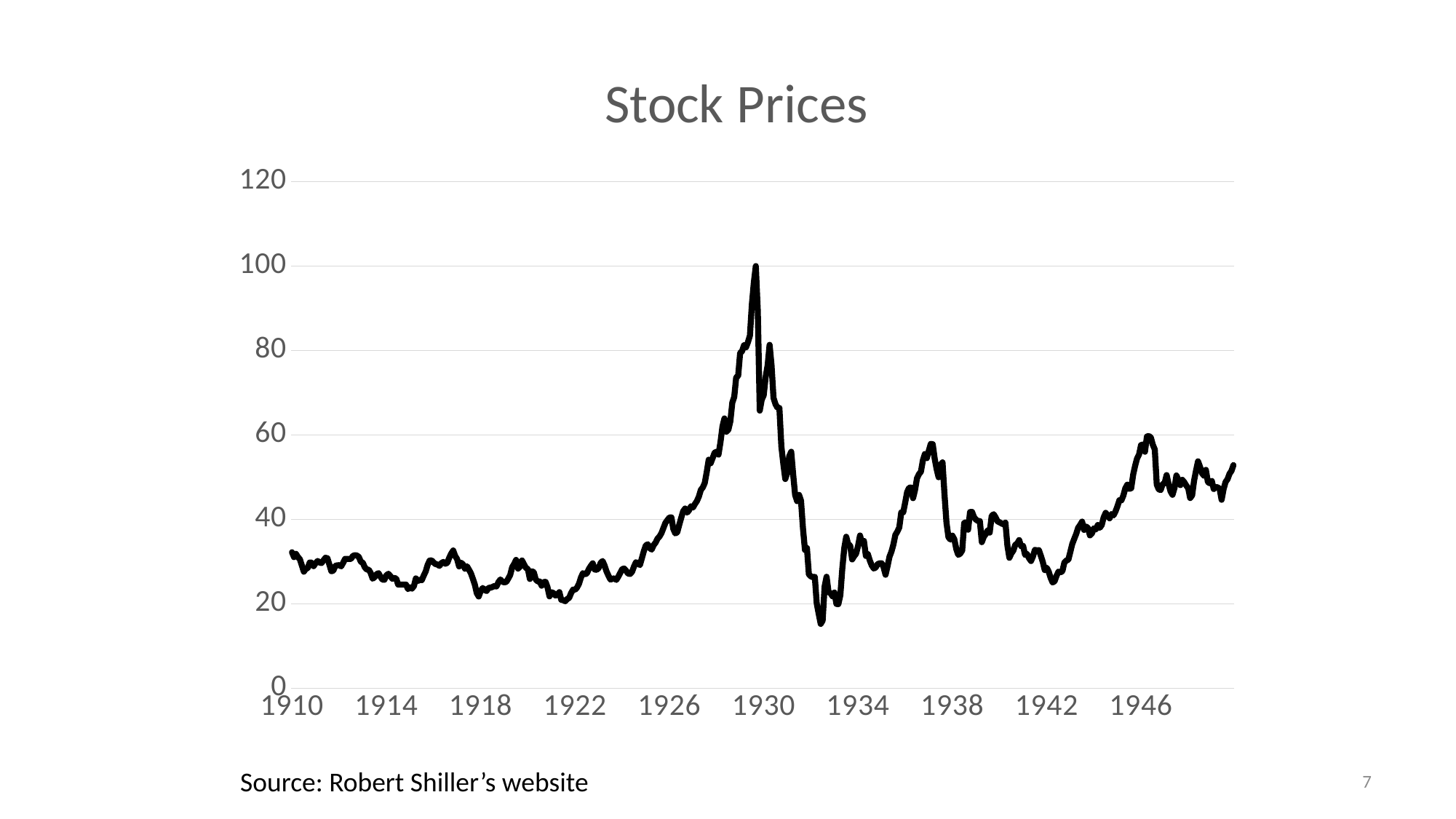
What is the title of the chart? Stock Prices What source is cited for the chart's data? Robert Shiller's website How many lines (series) are plotted on the chart? 1 Around which year does the stock price line reach its highest point? 1929 Is the value at the 1929 peak greater or less than 80? greater Do stock prices rise or fall between 1922 and 1929? rise Is the lowest value reached around 1932 greater or less than 20? less Do stock prices rise or fall between 1929 and 1932? fall Is the value in 1910 greater or less than 40? less Which is higher, the peak around 1929 or the peak around 1937? the peak around 1929 What kind of chart is shown on the slide? line chart